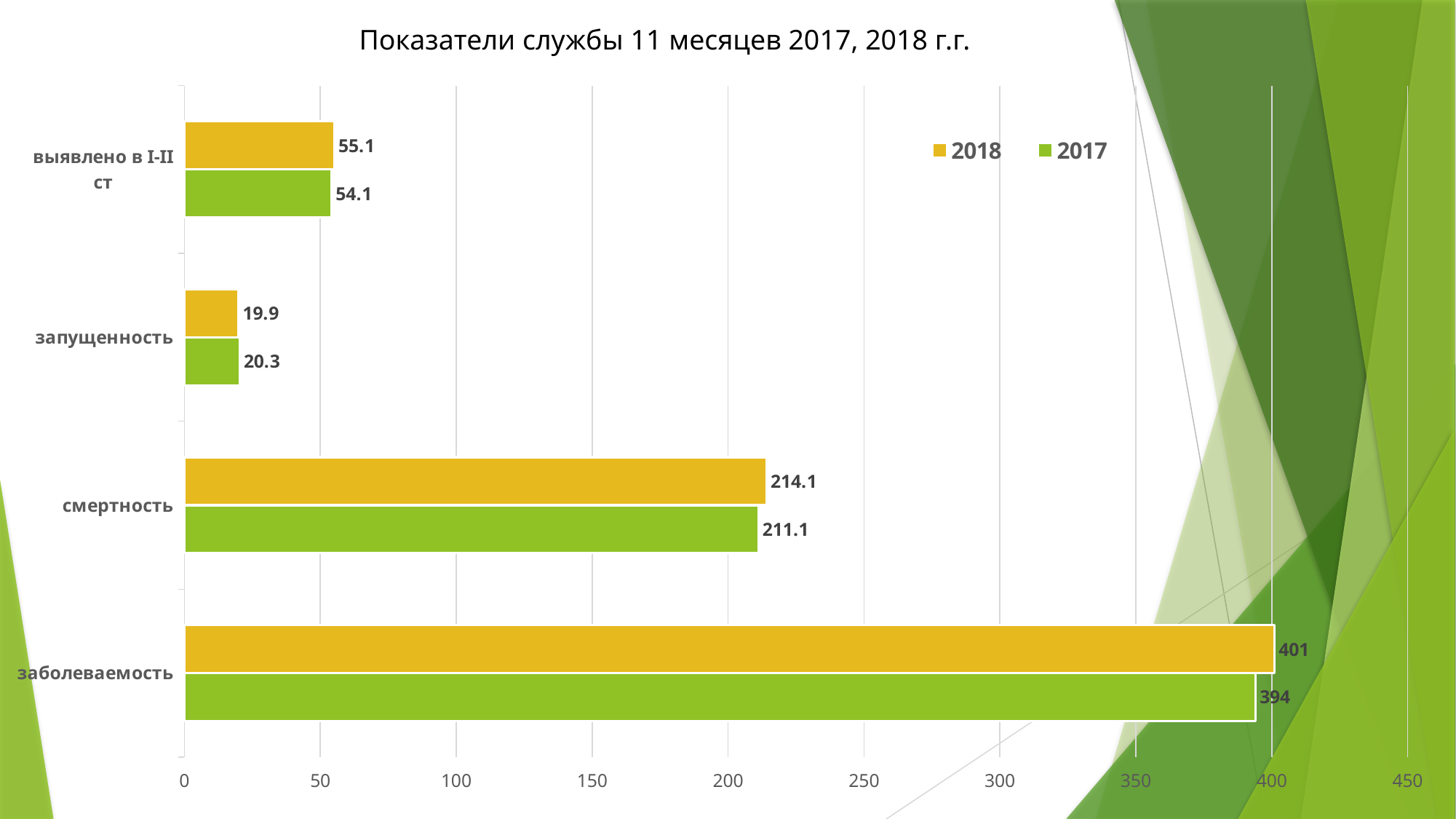
Which category has the highest 2018 value? заболеваемость What is the 2017 value for смертность? 211.1 What is the difference between the 2018 and 2017 values for заболеваемость? 7 What is the 2018 value for запущенность? 19.9 What is the 2018 value for заболеваемость? 401 What type of chart is shown on the slide? bar chart Which category has the lowest 2017 value? запущенность How many categories are shown on the chart? 4 Is the 2018 value for заболеваемость greater or less than 350? greater How many series does the legend list? 2 What is the 2017 value for выявлено в I-II ст? 54.1 What is the difference between the 2018 and 2017 values for смертность? 3